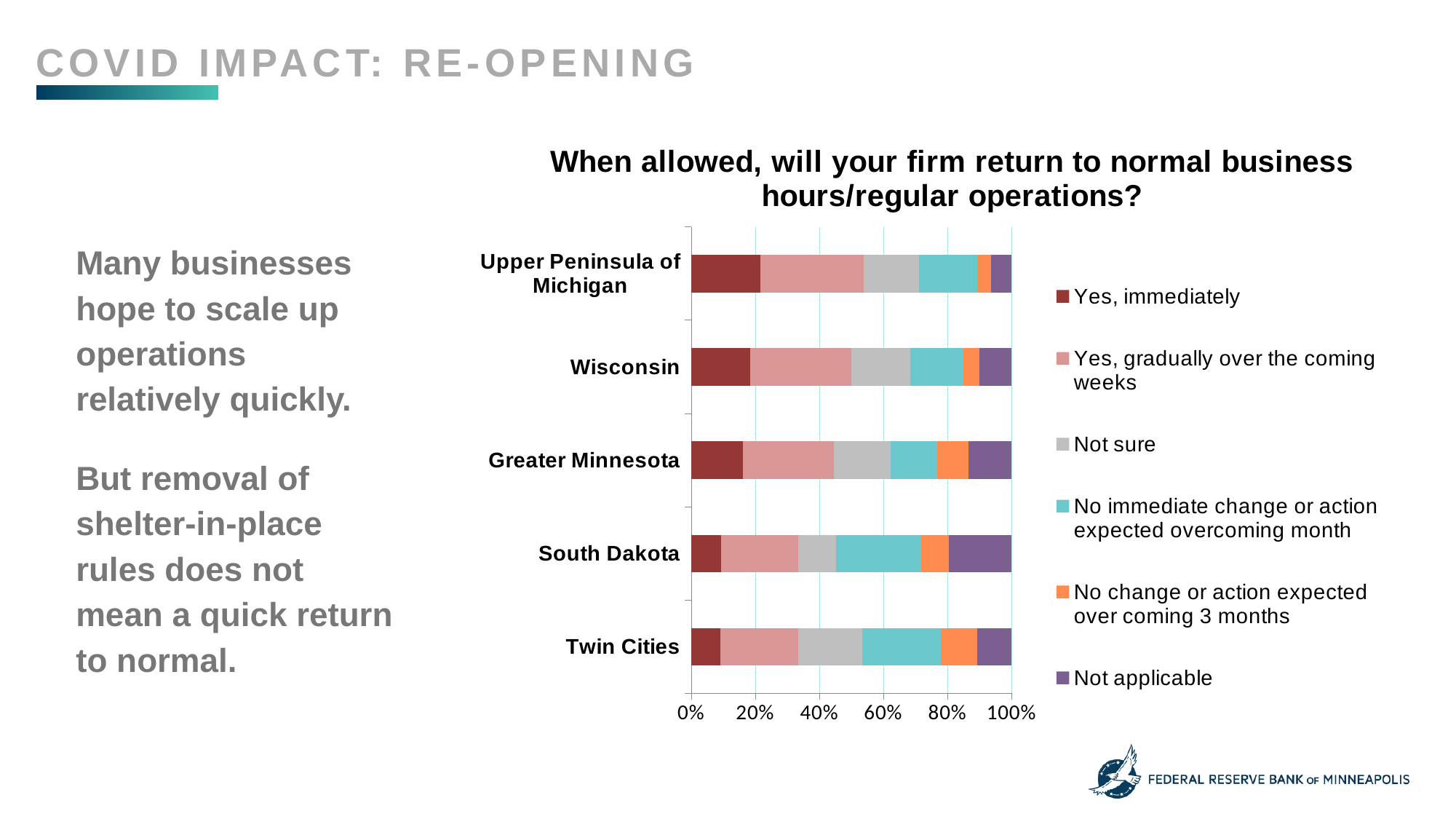
Which region has the largest "Not applicable" share? South Dakota How many response categories does the legend list? 6 Which region has the largest "Yes, immediately" share? Upper Peninsula of Michigan Which region has the smallest "Not applicable" share? Upper Peninsula of Michigan What kind of chart is shown on the slide? Stacked bar chart Which has a larger "Yes, immediately" share, Upper Peninsula of Michigan or Twin Cities? Upper Peninsula of Michigan Is the "Yes, immediately" share for Twin Cities greater or less than 20%? less What is the title of the chart? When allowed, will your firm return to normal business hours/regular operations? Is the "Yes, immediately" share for Greater Minnesota greater or less than 20%? less Which colour represents the "Not sure" response in the chart? Grey What does each stacked bar total on the x axis? 100% How many regions are plotted on the chart? 5